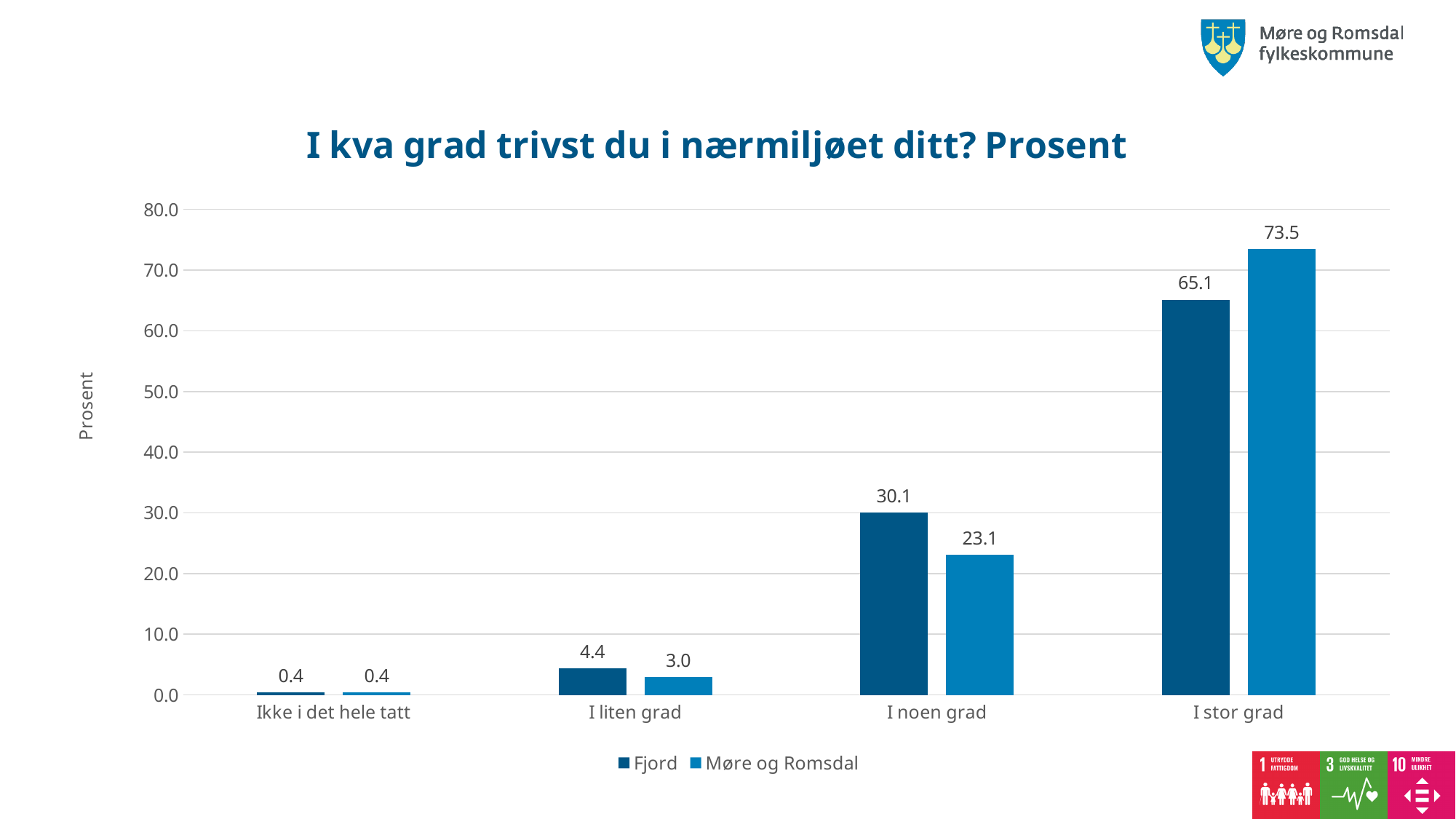
What is the difference between Møre og Romsdal and Fjord in the 'I stor grad' category? 8.4 What is the value for Fjord in the 'I stor grad' category? 65.1 Is the value for Møre og Romsdal in 'I stor grad' greater or less than 70.0? greater How many series does the legend list? 2 What is the value for Fjord in the 'I liten grad' category? 4.4 How many categories are shown on the x axis? 4 What is the value for Møre og Romsdal in the 'I noen grad' category? 23.1 Which category has the highest value for Møre og Romsdal? I stor grad Which category has the lowest value for Fjord? Ikke i det hele tatt In the 'I noen grad' category, which series has the larger value, Fjord or Møre og Romsdal? Fjord What is the title of the chart? I kva grad trivst du i nærmiljøet ditt? Prosent What kind of chart is shown on the slide? Bar chart